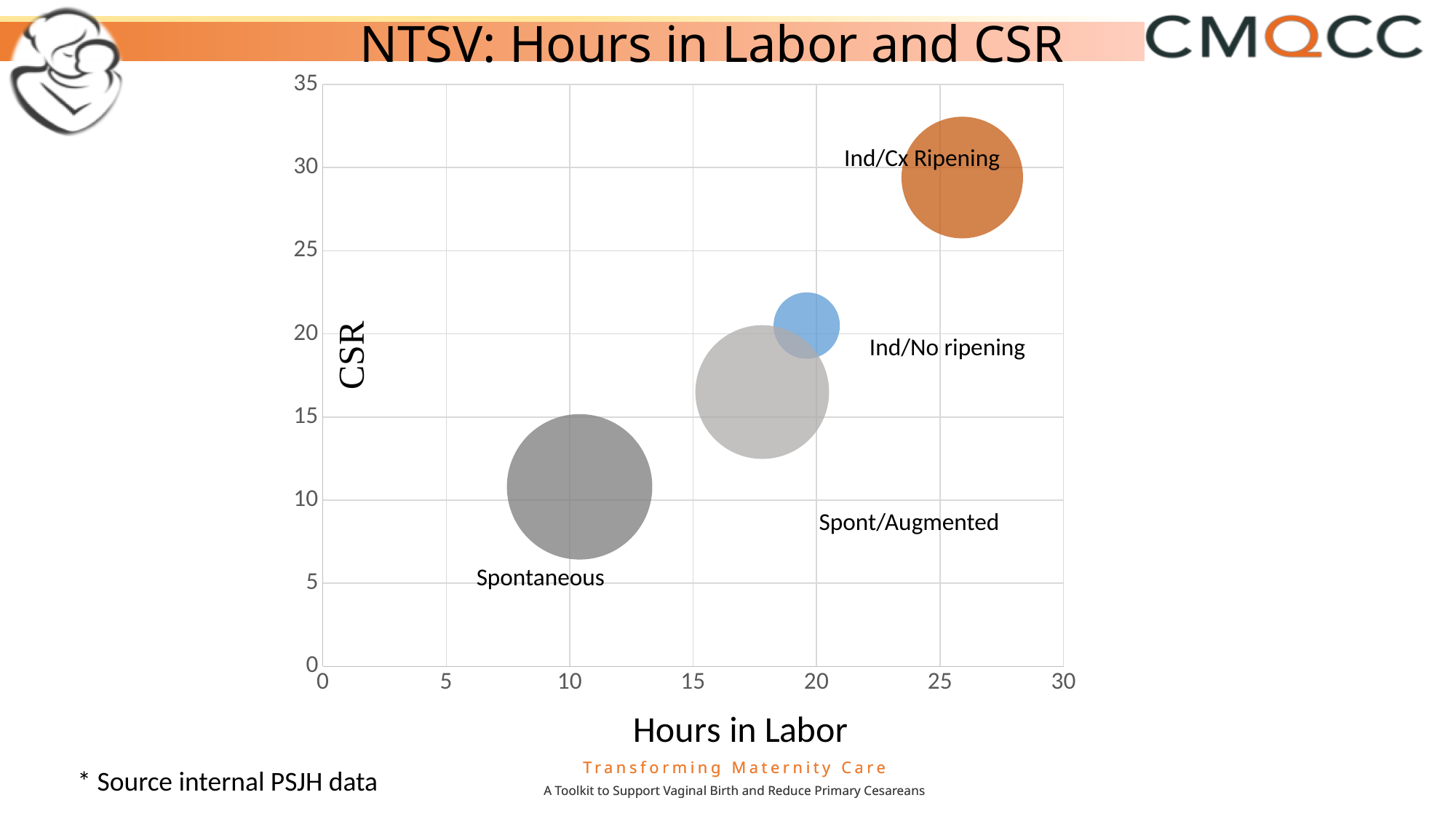
Which has the higher CSR, Spont/Augmented or Ind/No ripening? Ind/No ripening Which category has the highest CSR? Ind/Cx Ripening Is the CSR for Ind/Cx Ripening greater or less than 25? greater What kind of chart is shown on the slide? Bubble chart Which category has the most hours in labor? Ind/Cx Ripening Are the hours in labor for Spont/Augmented greater or less than 15? greater As hours in labor increase along the x axis, does CSR rise or fall? Rise Which category has the fewest hours in labor? Spontaneous Which category has the lowest CSR? Spontaneous How many bubbles (categories) are plotted on the chart? 4 Is the CSR for Spontaneous greater or less than 15? less What is the label of the y axis? CSR